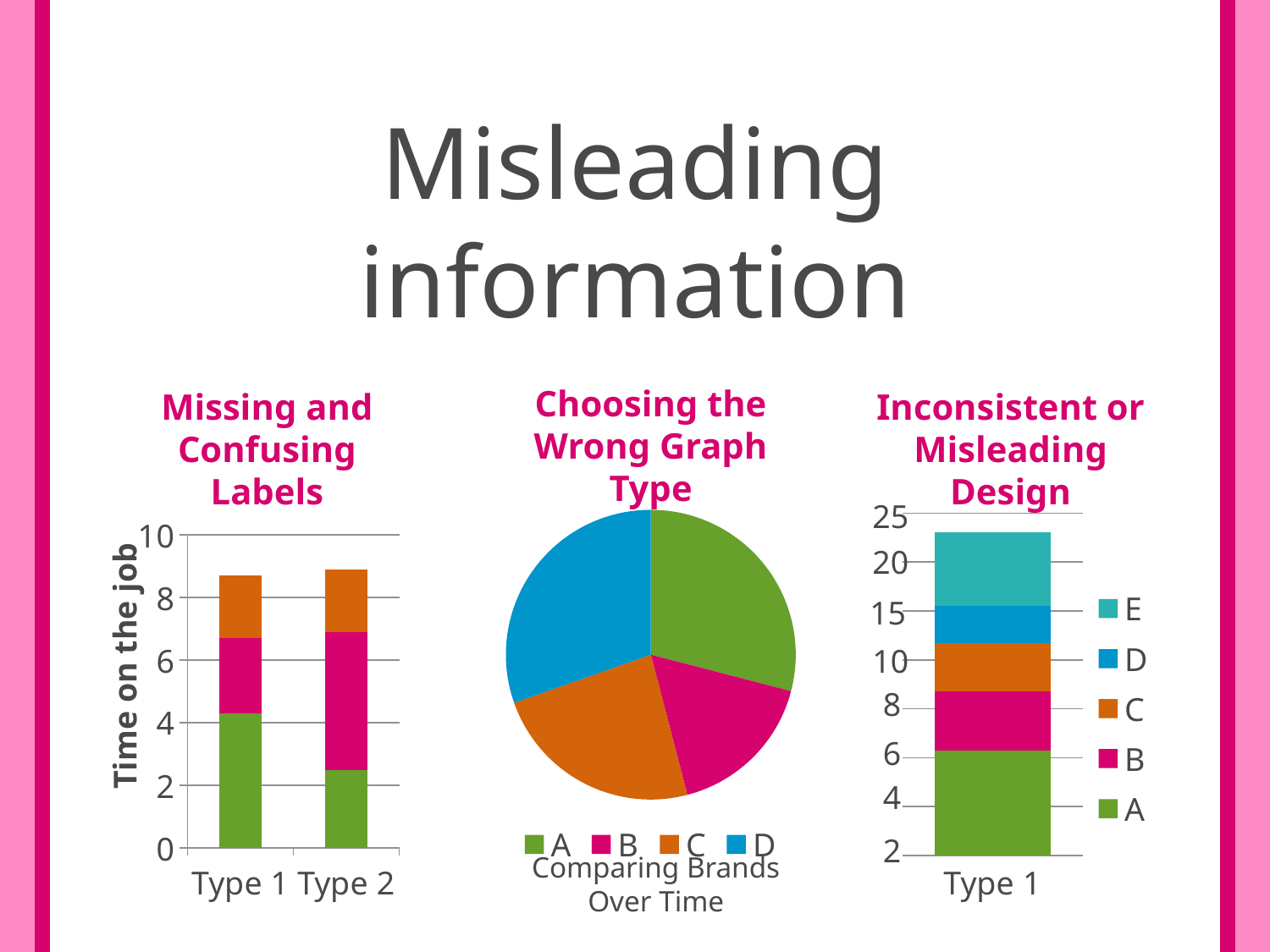
How many categories are shown on the x axis of the 'Inconsistent or Misleading Design' chart? 1 What kind of chart is the 'Inconsistent or Misleading Design' chart? bar chart In the 'Missing and Confusing Labels' chart, is the green segment of the Type 2 bar greater or less than 4? less What is the y-axis title of the 'Missing and Confusing Labels' chart? Time on the job How many series does the legend of the 'Inconsistent or Misleading Design' chart list? 5 What kind of chart is the 'Missing and Confusing Labels' chart? bar chart How many categories are shown on the x axis of the 'Missing and Confusing Labels' chart? 2 How many series does the legend of the 'Choosing the Wrong Graph Type' chart list? 4 In the 'Missing and Confusing Labels' chart, which bar has the larger green segment, Type 1 or Type 2? Type 1 In the 'Choosing the Wrong Graph Type' pie chart, which slice is the smallest? B What kind of chart is the 'Choosing the Wrong Graph Type' chart? pie chart In the 'Missing and Confusing Labels' chart, is the total height of the Type 1 bar greater or less than 6? greater